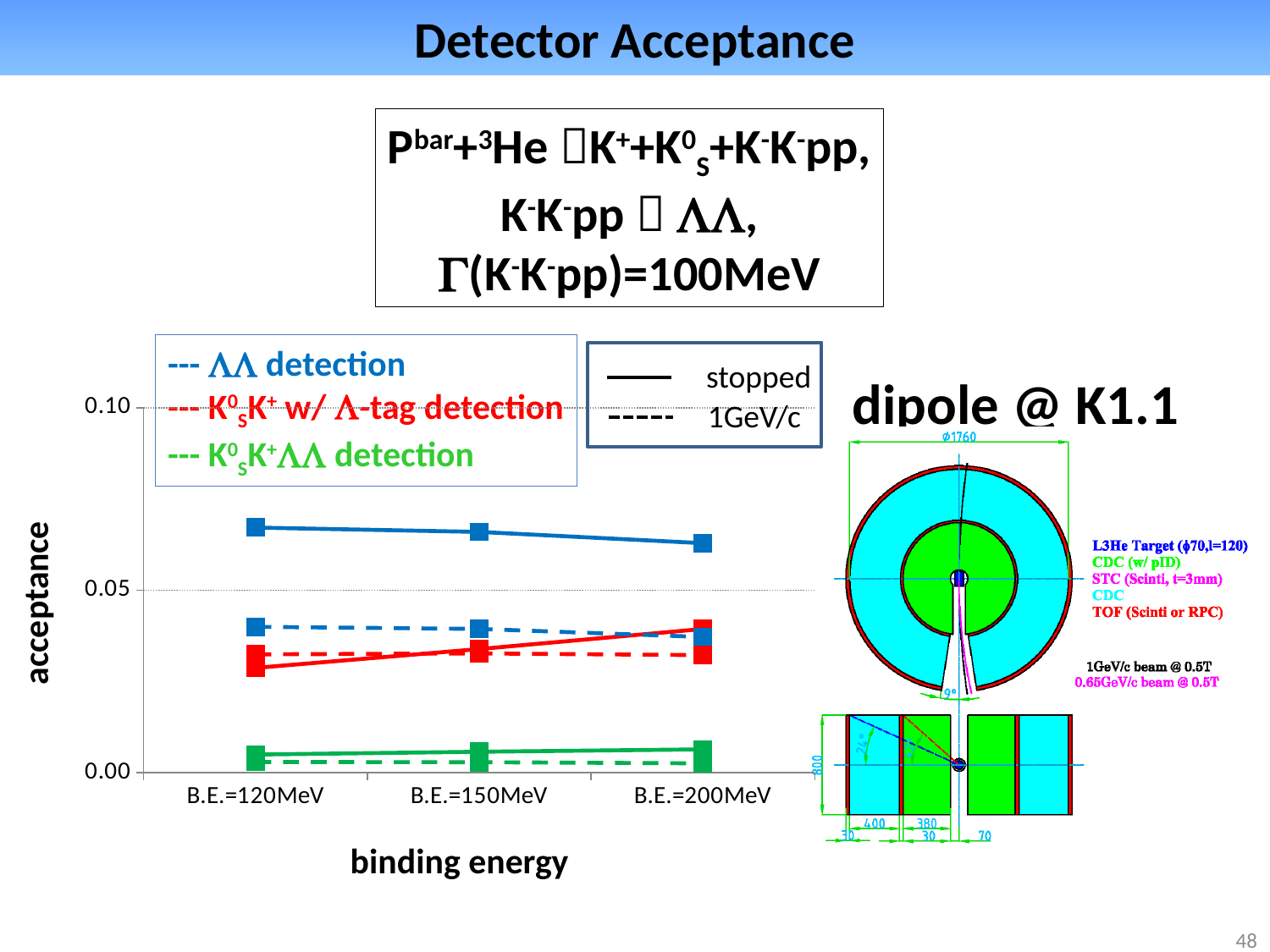
Is the value of the dashed ΛΛ detection line at B.E.=200MeV greater or less than 0.05? less What is the label of the y axis of the chart? acceptance Does the solid K0sK+ w/ Λ-tag detection line rise or fall from B.E.=120MeV to B.E.=200MeV? rise How many binding energy categories are shown on the x axis? 3 Which detection mode has the lowest acceptance at B.E.=120MeV? K0sK+ΛΛ detection How many detection modes does the coloured legend list? 3 What kind of chart is shown on the slide? line chart Does the solid ΛΛ detection line rise or fall from B.E.=120MeV to B.E.=200MeV? fall Is the value of the solid ΛΛ detection line at B.E.=120MeV greater or less than 0.05? greater What is the title of the slide containing the chart? Detector Acceptance At B.E.=200MeV, which is larger: the solid ΛΛ detection value or the solid K0sK+ w/ Λ-tag detection value? ΛΛ detection Is the value of the solid K0sK+ΛΛ detection line at B.E.=150MeV greater or less than 0.05? less